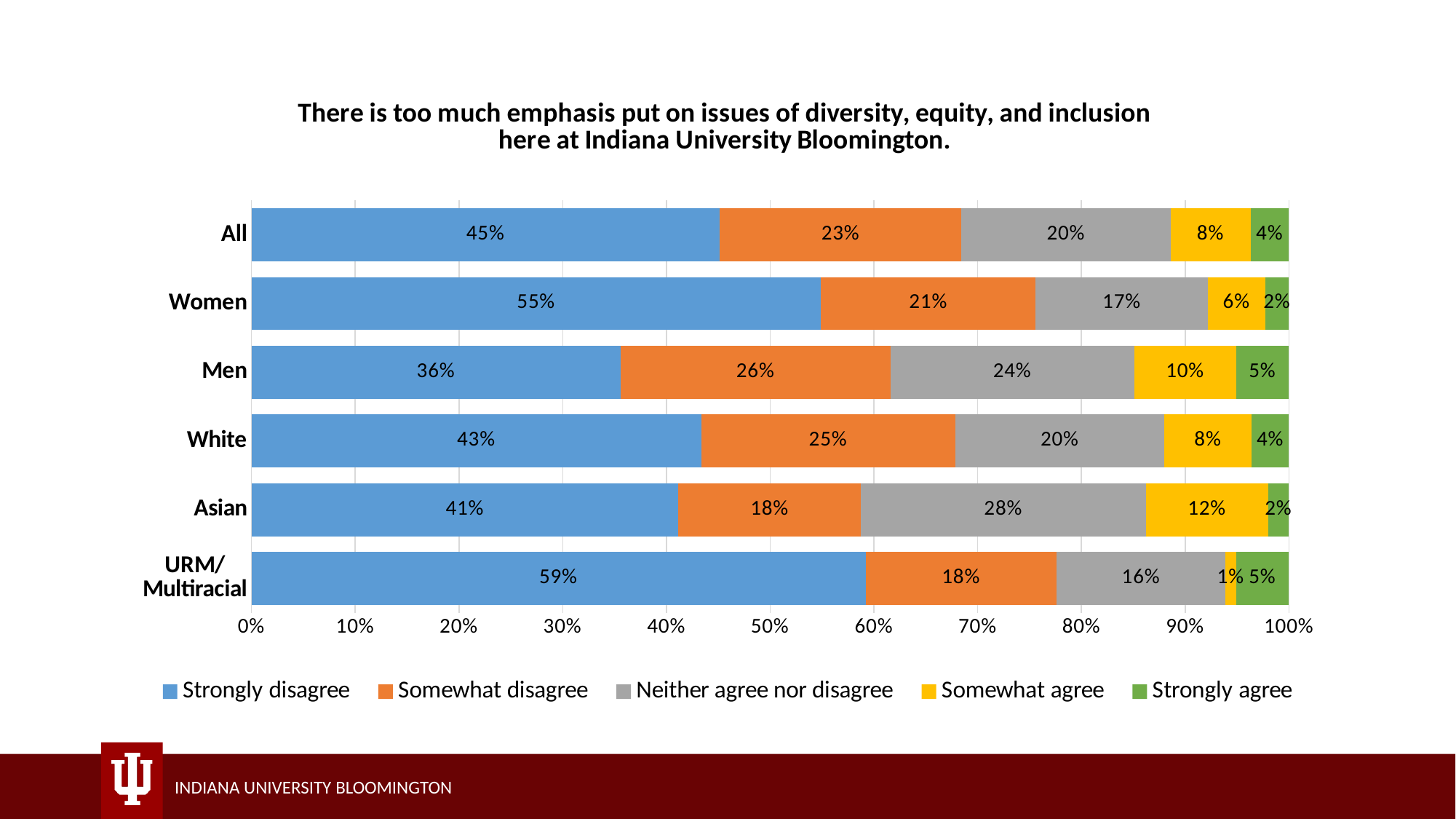
What is the combined percentage of Somewhat agree and Strongly agree for the All group? 12% Which group has the lowest percentage of Strongly disagree responses? Men Which group has the highest percentage of Strongly disagree responses? URM/Multiracial How many response categories does the legend list? 5 How many groups (categories) are shown on the chart? 6 What percentage of Asian respondents somewhat agree? 12% What percentage of Women strongly disagree with the statement? 55% What percentage of Men neither agree nor disagree? 24% What is the difference between the Strongly disagree percentages for Women and Men? 19% Which colour represents Strongly agree in the chart? Green Which is larger: the Somewhat disagree share for White respondents or for Asian respondents? White What type of chart is shown on the slide? Stacked bar chart